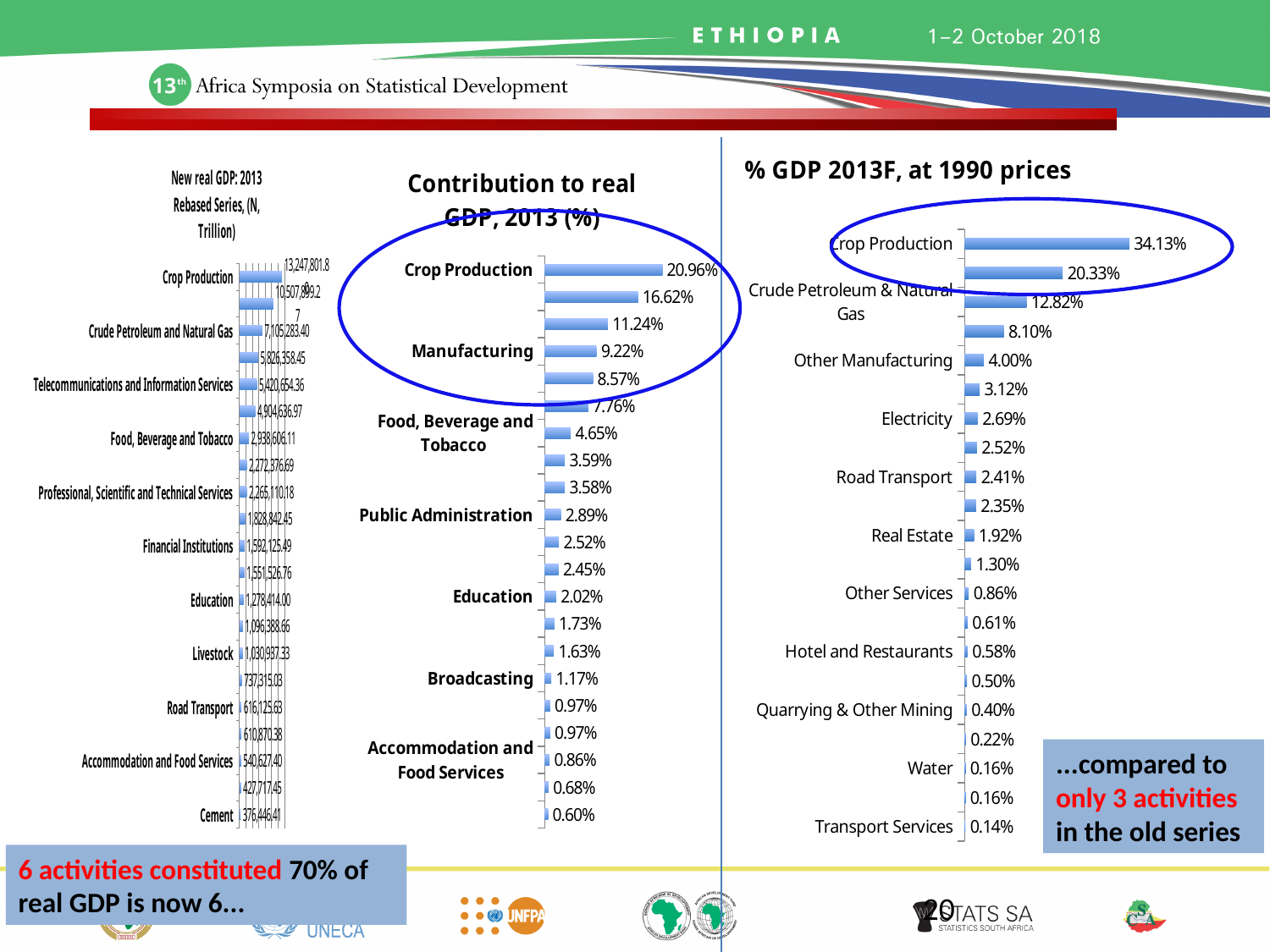
In the '% GDP 2013F, at 1990 prices' chart, what is the value for Other Manufacturing? 4.00% In the 'Contribution to real GDP, 2013 (%)' chart, what is the value for Manufacturing? 9.22% In the 'New real GDP: 2013 Rebased Series' chart on the left, what is the value for Crop Production? 13,247,801.8 What type of chart is the '% GDP 2013F, at 1990 prices' chart? Bar chart In the 'Contribution to real GDP, 2013 (%)' chart, what is the value for Crop Production? 20.96% In the '% GDP 2013F, at 1990 prices' chart, what is the value for Crop Production? 34.13% In the 'Contribution to real GDP, 2013 (%)' chart, which category has the highest value? Crop Production In the '% GDP 2013F, at 1990 prices' chart, what is the difference between Crop Production and Crude Petroleum & Natural Gas? 21.31% In the 'Contribution to real GDP, 2013 (%)' chart, what is the difference between Manufacturing and Education? 7.20% In the 'Contribution to real GDP, 2013 (%)' chart, what is the value for Public Administration? 2.89% In the '% GDP 2013F, at 1990 prices' chart, what is the value for Transport Services? 0.14% In the '% GDP 2013F, at 1990 prices' chart, which is larger, Electricity or Road Transport? Electricity